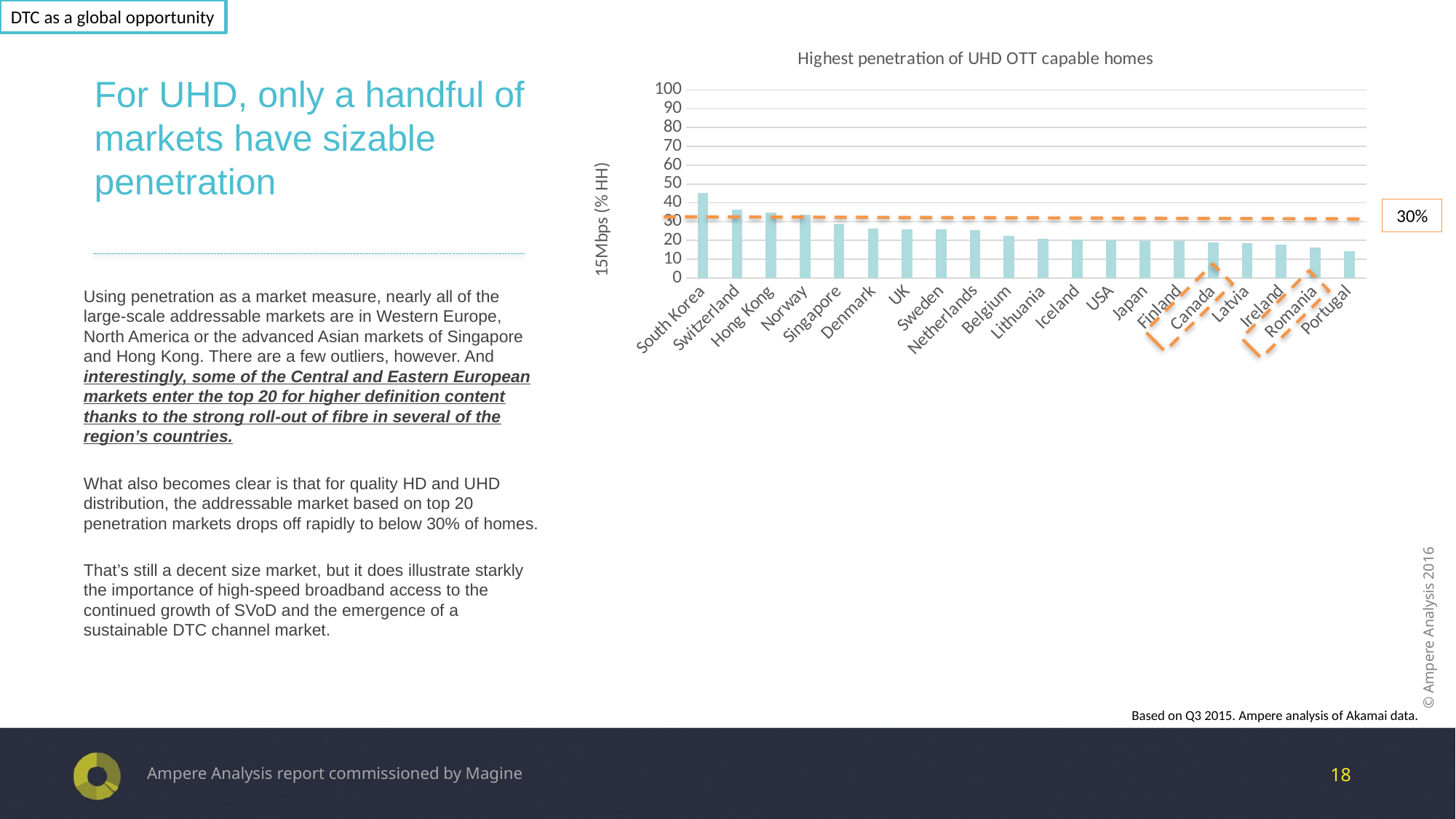
Is the value for Switzerland greater or less than 30? greater Is the value for Portugal greater or less than 20? less Is the value for South Korea greater or less than 40? greater What kind of chart is shown on the slide? Bar chart Do the bar values rise or fall from left to right along the x axis? Fall Which country has the lowest penetration of UHD OTT capable homes? Portugal What value does the orange dashed horizontal line on the chart mark? 30% Which country has the highest penetration of UHD OTT capable homes? South Korea What is the title of the chart? Highest penetration of UHD OTT capable homes Which has a higher value, Switzerland or Denmark? Switzerland How many countries are plotted in the chart? 20